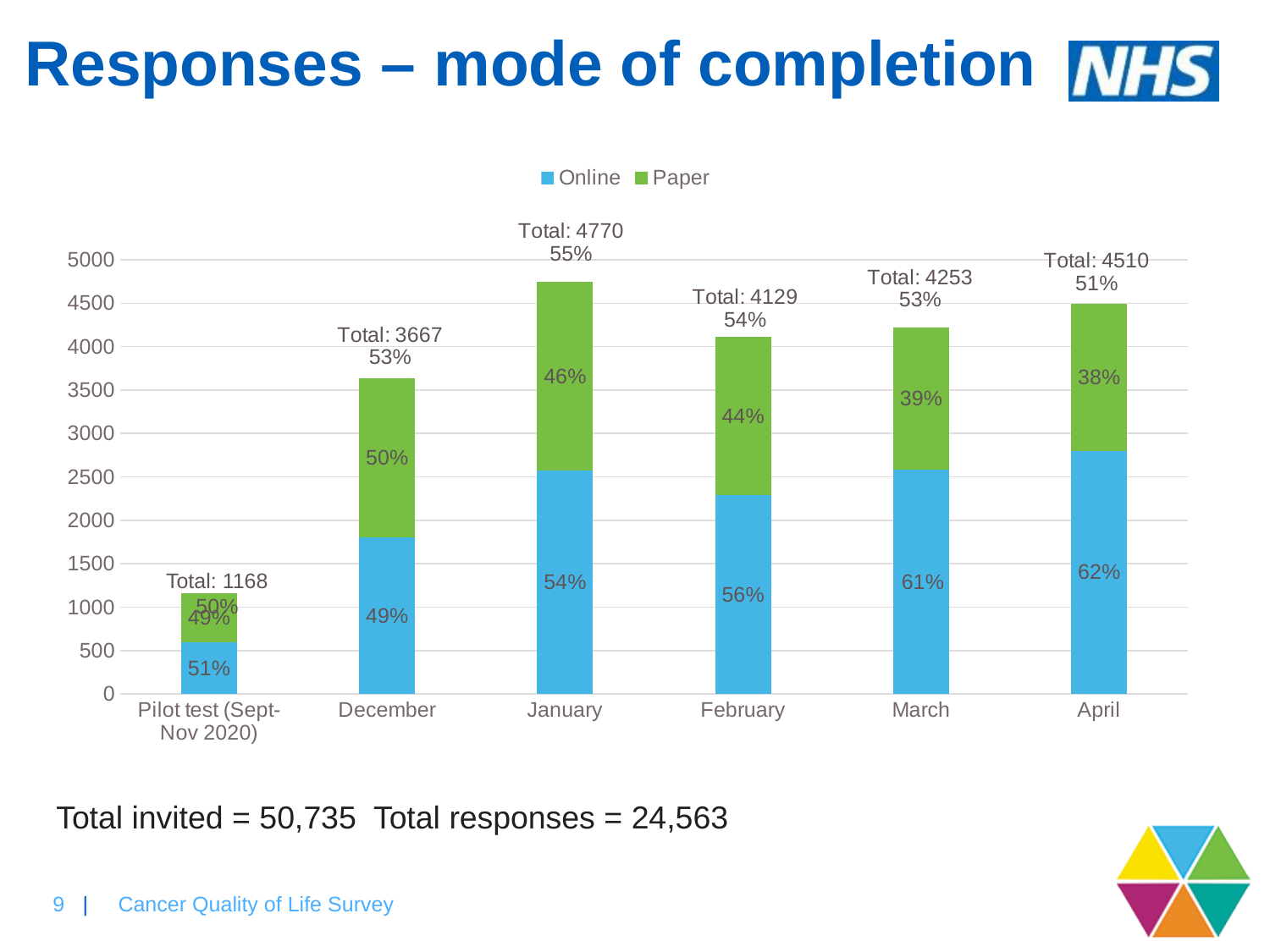
How many categories are shown on the x axis? 6 Which has a larger total number of responses, March or April? April How many series does the legend list? 2 What percentage of March responses were completed online? 61% What is the total number of responses shown for January? 4770 What percentage of April responses were completed on paper? 38% What type of chart is shown on the slide? stacked bar chart Is the value for Online responses in April greater or less than 2500? greater What is the total number of responses shown for the Pilot test (Sept-Nov 2020)? 1168 Which category has the lowest total number of responses? Pilot test (Sept-Nov 2020) What is the difference between the total responses for January and February? 641 Which month has the highest total number of responses? January